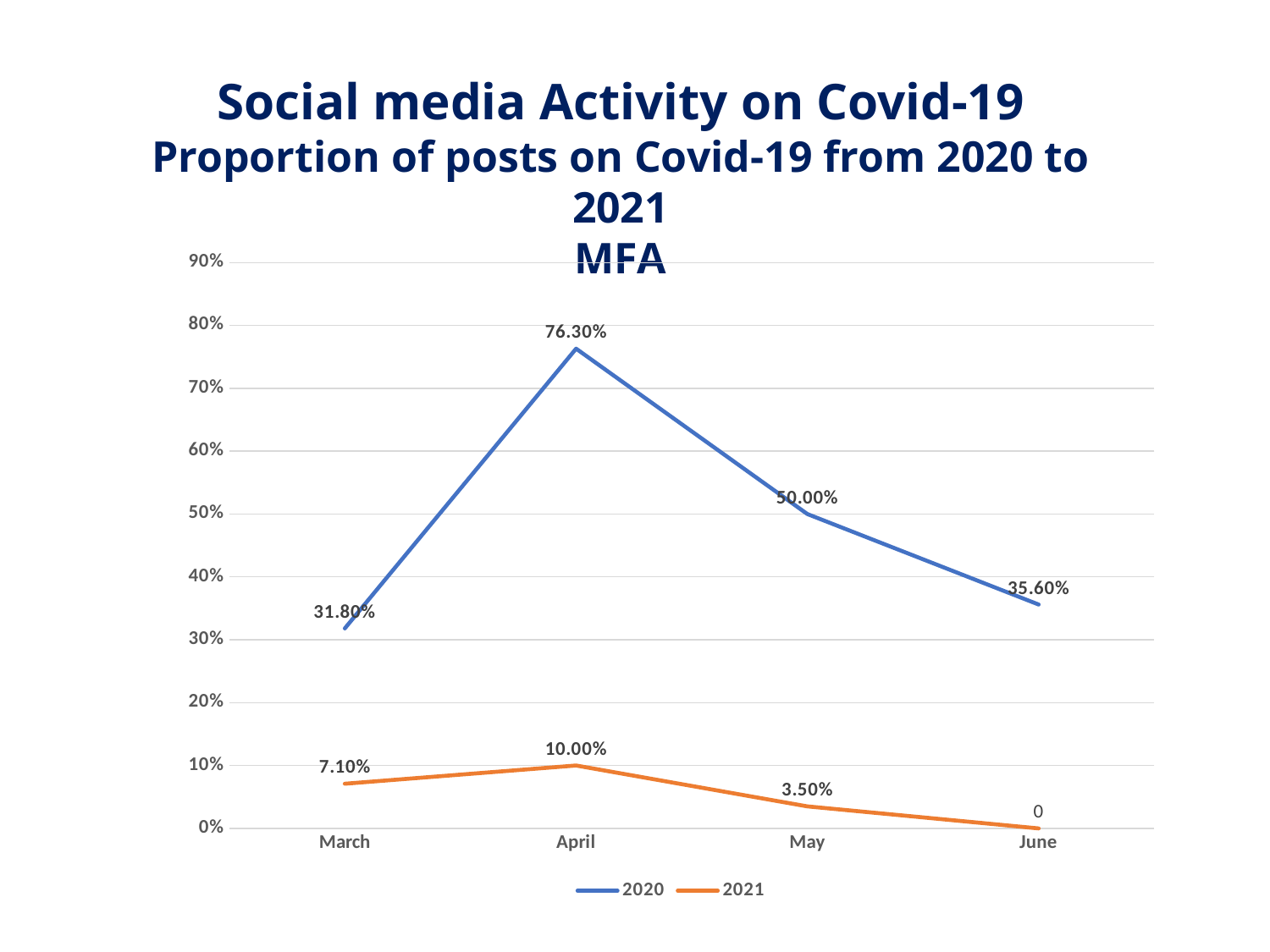
What is the difference between the 2020 values for April and May? 26.30% What kind of chart is shown? line chart Is the value for 2020 in May greater or less than 40%? greater How many series does the legend list? 2 What is the value for 2020 in April? 76.30% What is the value for 2021 in June? 0 How many months are shown on the x axis? 4 Which is larger, the 2021 value for March or the 2021 value for April? April In which month is the 2020 series lowest? March In which month is the 2020 series highest? April What is the value for 2020 in June? 35.60% What is the value for 2021 in May? 3.50%